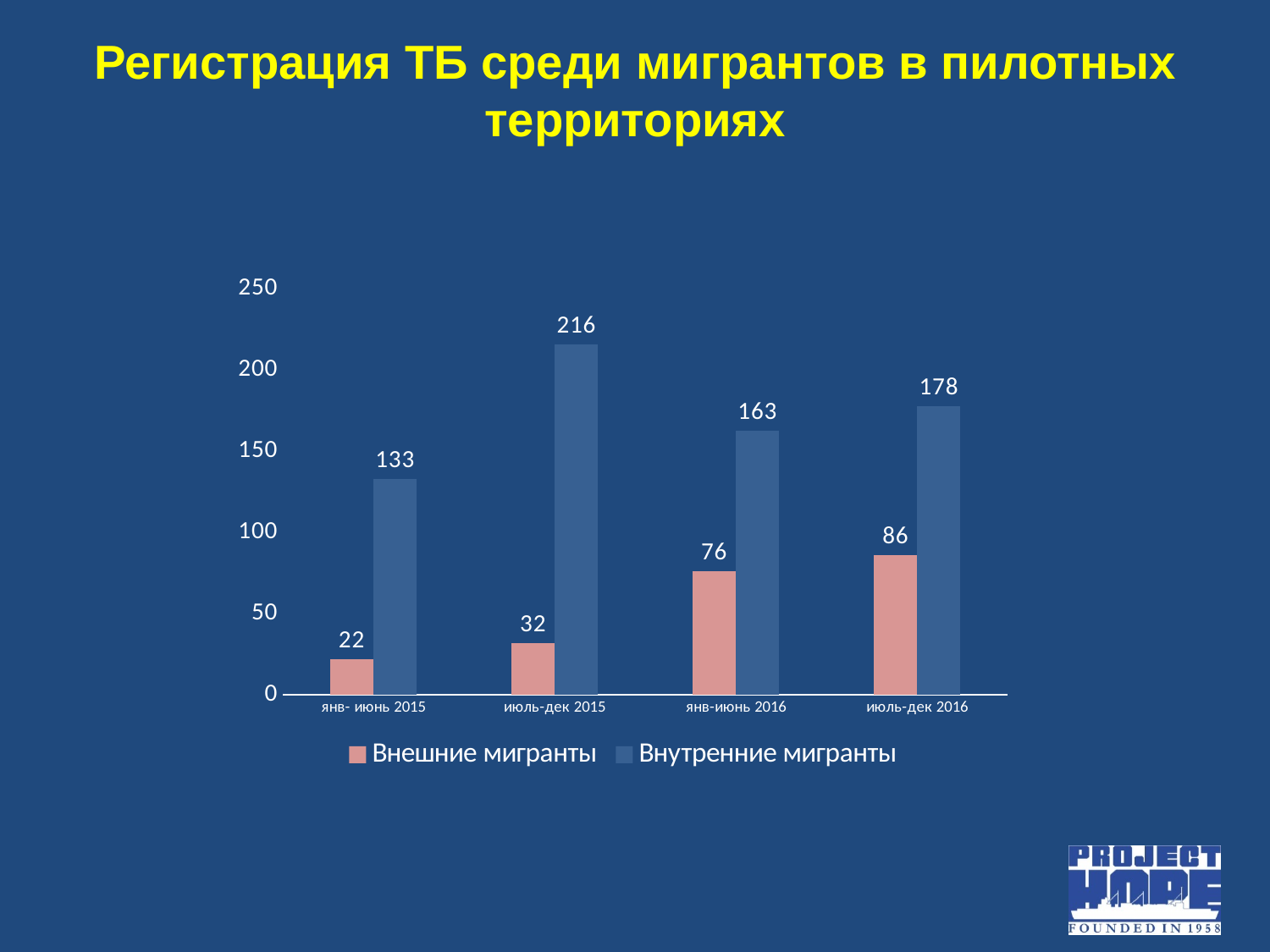
How many periods are shown on the x axis? 4 What is the difference between Внутренние мигранты and Внешние мигранты in янв-июнь 2016? 87 What is the value for Внешние мигранты in янв- июнь 2015? 22 How many series does the legend list? 2 What is the title of the chart on the slide? Регистрация ТБ среди мигрантов в пилотных территориях What is the value for Внутренние мигранты in июль-дек 2015? 216 Do the values for Внешние мигранты rise or fall across the periods from янв- июнь 2015 to июль-дек 2016? Rise Which is larger: Внутренние мигранты in янв- июнь 2015 or Внутренние мигранты in июль-дек 2016? Внутренние мигранты in июль-дек 2016 What is the value for Внешние мигранты in июль-дек 2016? 86 In which period is the value for Внешние мигранты lowest? янв- июнь 2015 In which period is the value for Внутренние мигранты highest? июль-дек 2015 What kind of chart is shown on the slide? Bar chart